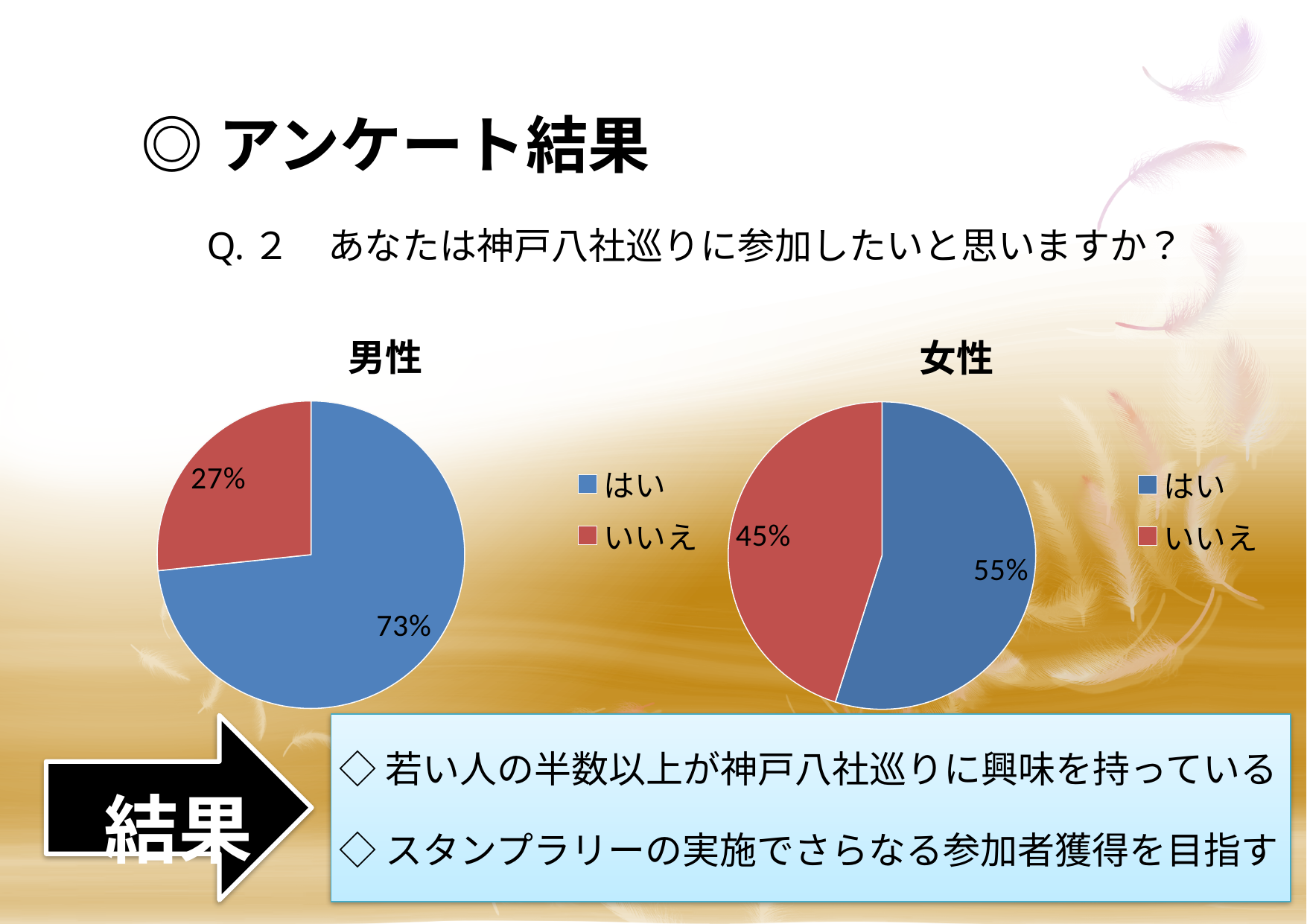
Which chart has the larger はい share, 男性 or 女性? 男性 In the 男性 chart, what percentage answered はい? 73% How many entries does the legend of the 女性 chart list? 2 What type of chart is the 男性 chart? pie chart In the 男性 chart, which answer has the largest slice? はい In the 女性 chart, which answer has the smallest slice? いいえ In the 男性 chart, what is the difference between the はい and いいえ percentages? 46% In the 女性 chart, what percentage answered いいえ? 45% In the 男性 chart, what percentage answered いいえ? 27% In the 女性 chart, what is the difference between the はい and いいえ percentages? 10% In the 女性 chart, what percentage answered はい? 55% In the 男性 chart, what colour is the はい slice? blue